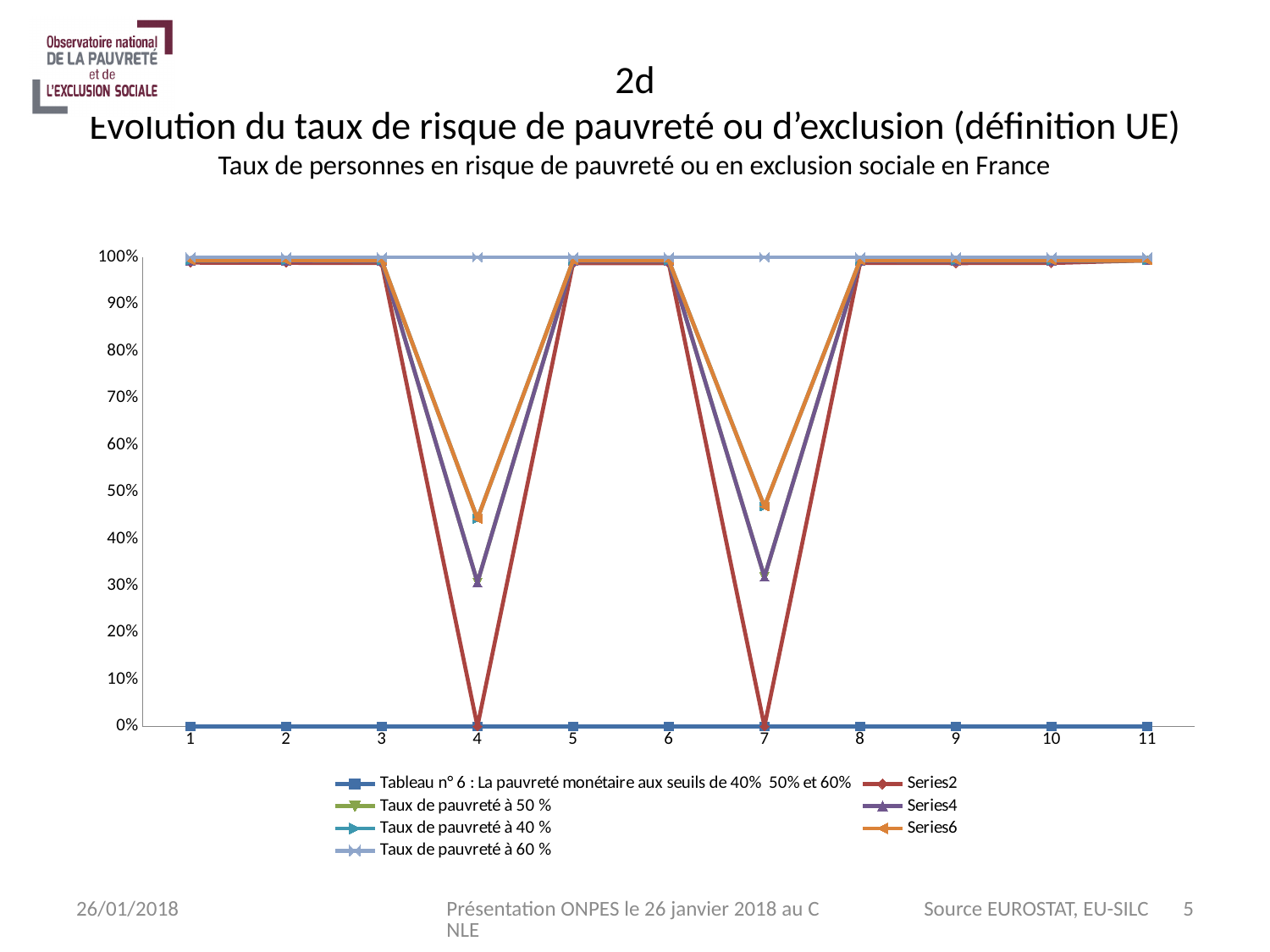
Is the value for Series4 at x = 7 greater or less than 40%? less Which series has the highest value at x = 4? Taux de pauvreté à 60 % Is the value for Taux de pauvreté à 60 % at x = 4 greater or less than 90%? greater Is the value for Series6 at x = 4 greater or less than 40%? greater Does the value for Series2 rise or fall between x = 3 and x = 4? fall How many series does the legend list? 7 What kind of chart is shown on the slide? line chart What is the subtitle shown above the chart? Taux de personnes en risque de pauvreté ou en exclusion sociale en France How many points are there along the x axis? 11